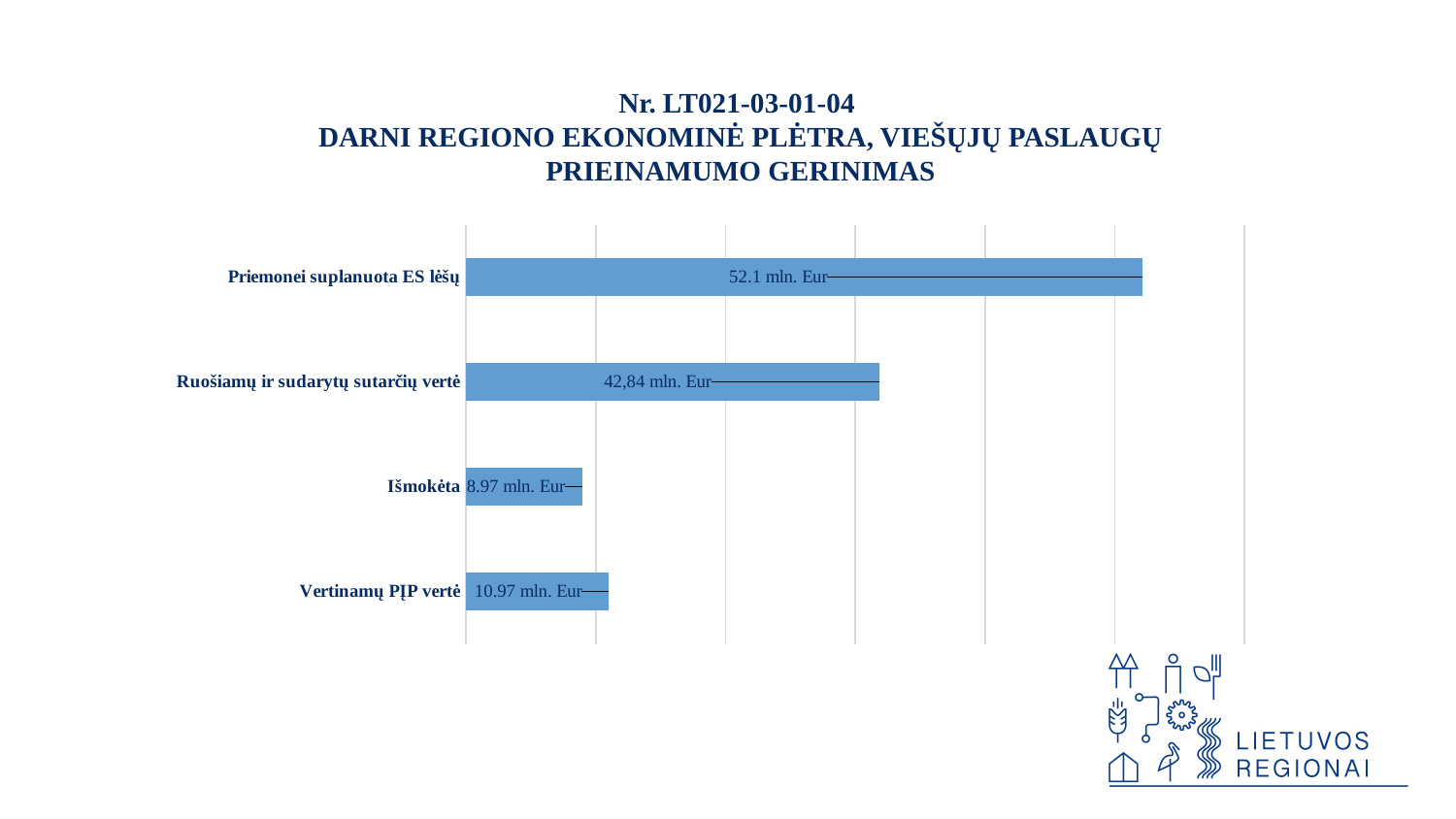
What value is shown for "Priemonei suplanuota ES lėšų"? 52.1 mln. Eur What is the difference between the value for "Vertinamų PĮP vertė" and the value for "Išmokėta"? 2.00 mln. Eur Which is larger, the value for "Priemonei suplanuota ES lėšų" or the value for "Ruošiamų ir sudarytų sutarčių vertė"? Priemonei suplanuota ES lėšų What kind of chart is shown on the slide? Bar chart What value is shown for "Ruošiamų ir sudarytų sutarčių vertė"? 42,84 mln. Eur Which is larger, the value for "Vertinamų PĮP vertė" or the value for "Išmokėta"? Vertinamų PĮP vertė Which category has the lowest value? Išmokėta What value is shown for "Vertinamų PĮP vertė"? 10.97 mln. Eur What value is shown for "Išmokėta"? 8.97 mln. Eur What is the measure number given in the slide title? Nr. LT021-03-01-04 Which category has the highest value? Priemonei suplanuota ES lėšų How many categories are shown in the chart? 4